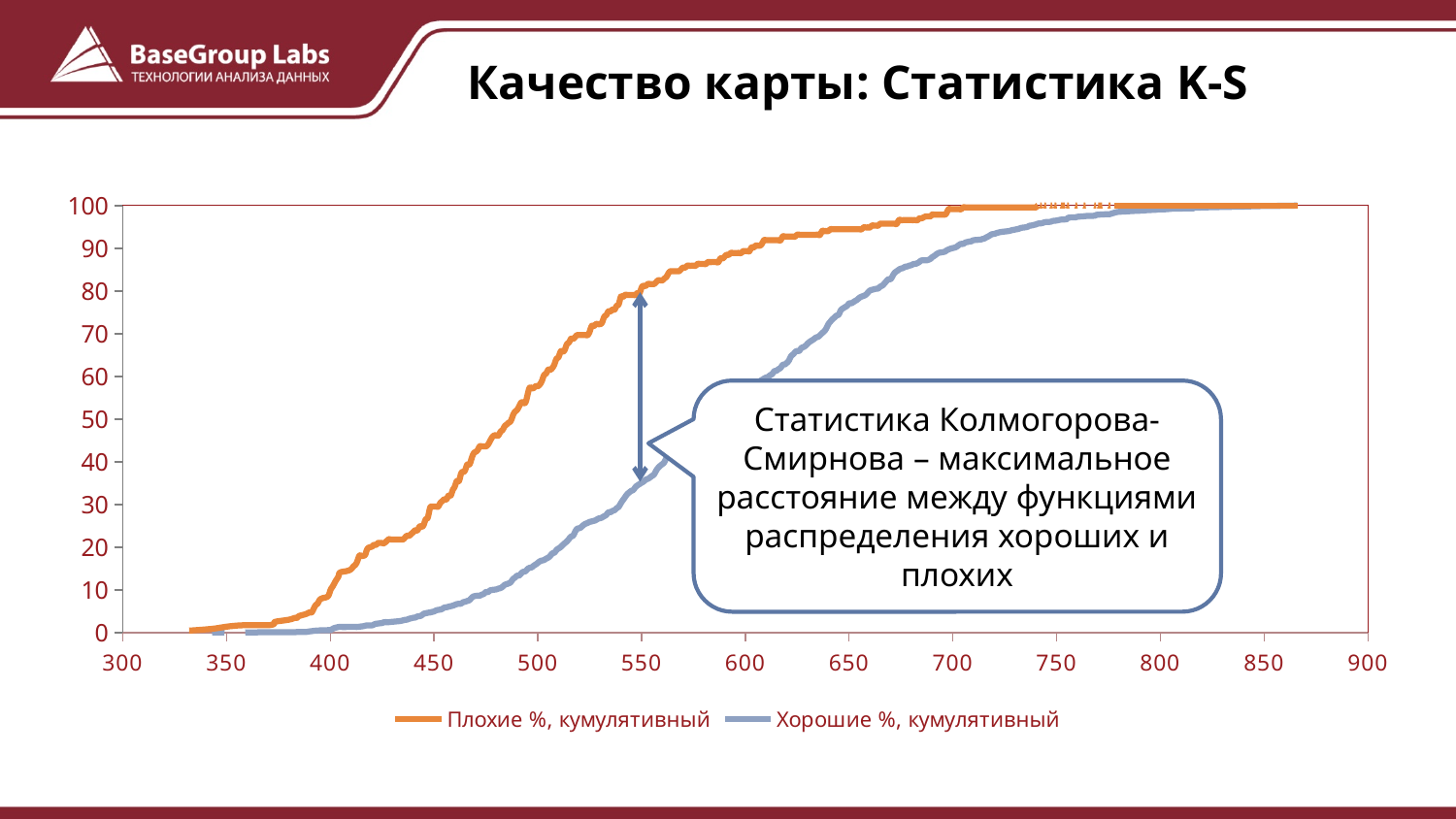
Do the values of the 'Плохие %, кумулятивный' series rise or fall as the x axis increases? rise Is the value of 'Хорошие %, кумулятивный' at x = 500 greater or less than 30? less Is the value of 'Плохие %, кумулятивный' at x = 650 greater or less than 80? greater Is the value of 'Плохие %, кумулятивный' at x = 550 greater or less than 70? greater Do the values of the 'Хорошие %, кумулятивный' series rise or fall as the x axis increases? rise At x = 500, which series has the larger value, 'Плохие %, кумулятивный' or 'Хорошие %, кумулятивный'? Плохие %, кумулятивный What is the title of the slide containing the chart? Качество карты: Статистика K-S What are the two series named in the legend? Плохие %, кумулятивный; Хорошие %, кумулятивный How many series does the legend list? 2 What kind of chart is shown on the slide? line chart